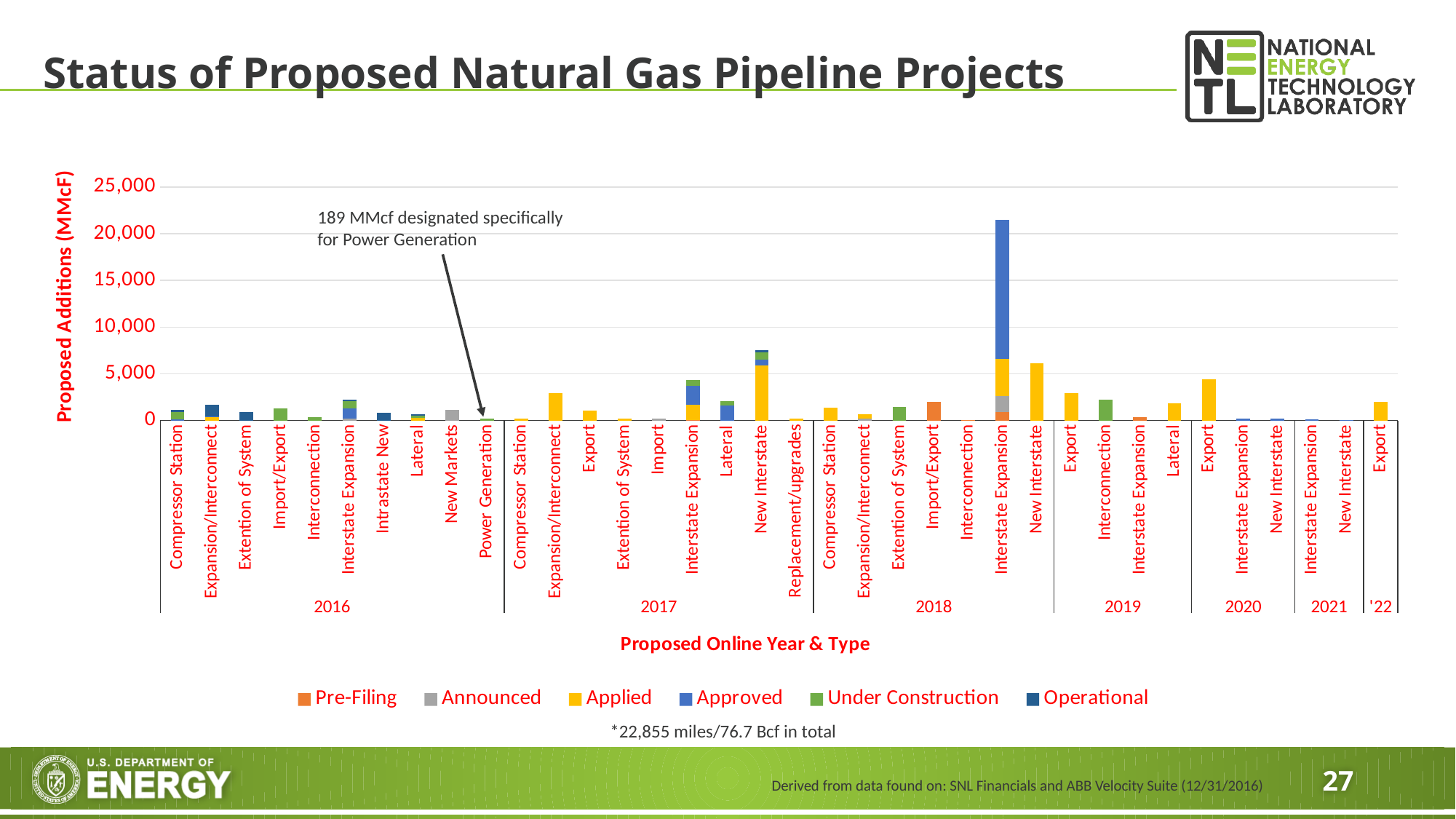
According to the annotation, how much capacity is designated specifically for Power Generation in 2016? 189 MMcf Which is larger, the Interstate Expansion bar for 2017 or the New Interstate bar for 2017? New Interstate for 2017 Is the value for New Interstate in 2017 greater or less than 5,000? greater How many series does the legend list? 6 What kind of chart is shown on the slide? Stacked bar chart How many type categories are shown under the 2016 year group? 10 How many proposed online year groups are shown along the x axis? 7 Which is larger, the Export bar for 2019 or the Export bar for 2020? Export for 2020 What is the title of the vertical axis? Proposed Additions (MMcF) Is the value for Export in 2020 greater or less than 5,000? less Is the value for Interstate Expansion in 2018 greater or less than 20,000? greater Which year-and-type category has the highest proposed additions? Interstate Expansion (2018)